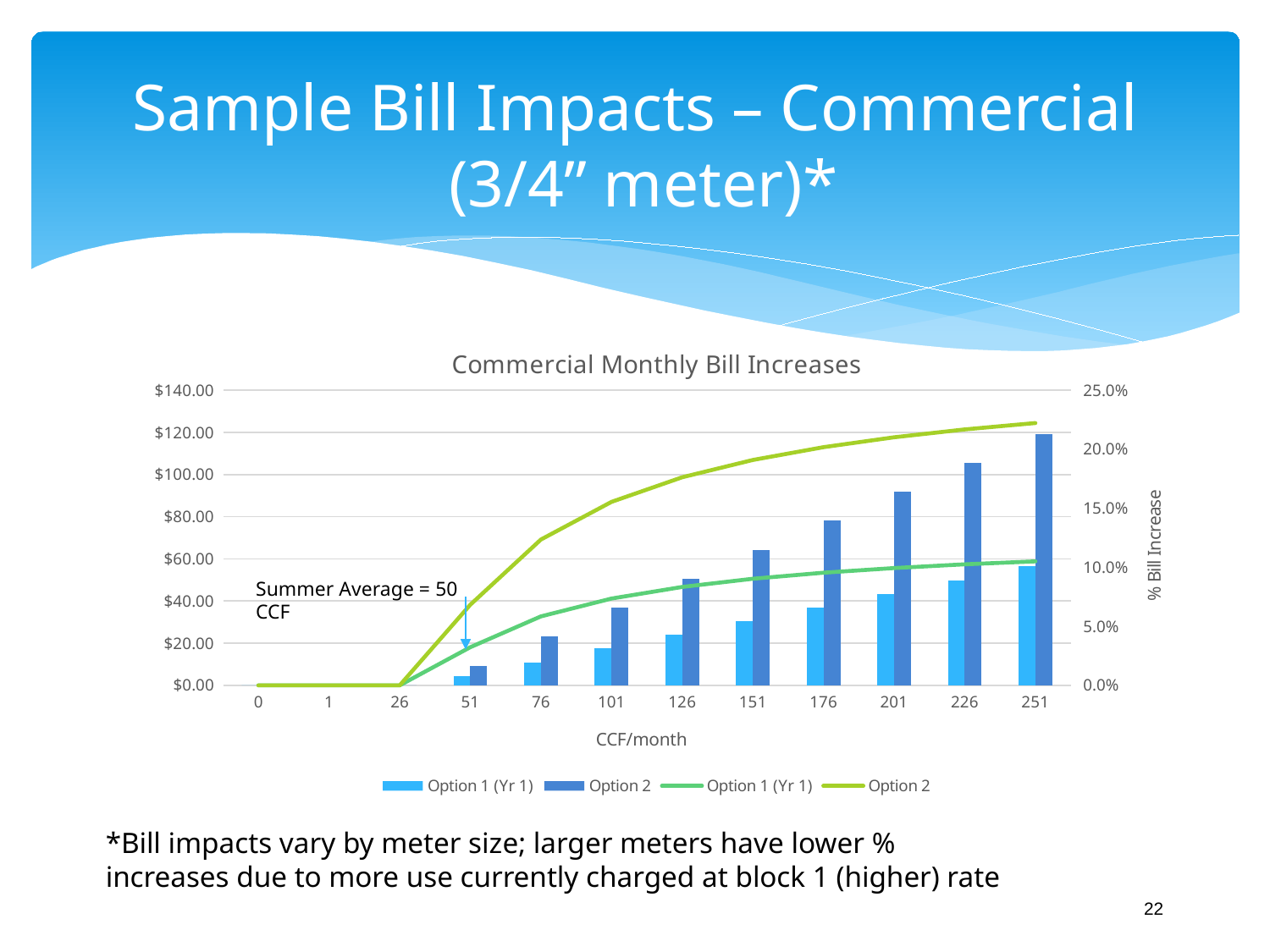
What is the title of the chart? Commercial Monthly Bill Increases At which CCF/month value is the Option 2 bar the highest? 251 What kind of chart is shown on the slide? Combined bar and line chart Is the Option 2 line at 251 CCF/month greater or less than 20.0%? greater How many CCF/month categories are shown on the x axis? 12 Is the Option 2 bar at 201 CCF/month greater or less than $80.00? greater Do the Option 2 bars rise or fall as CCF/month increases from 26 to 251? rise At 251 CCF/month, which bar is larger: Option 1 (Yr 1) or Option 2? Option 2 What is the label on the right-hand vertical axis? % Bill Increase Is the Option 1 (Yr 1) bar at 101 CCF/month greater or less than $20.00? less How many series does the legend list? 4